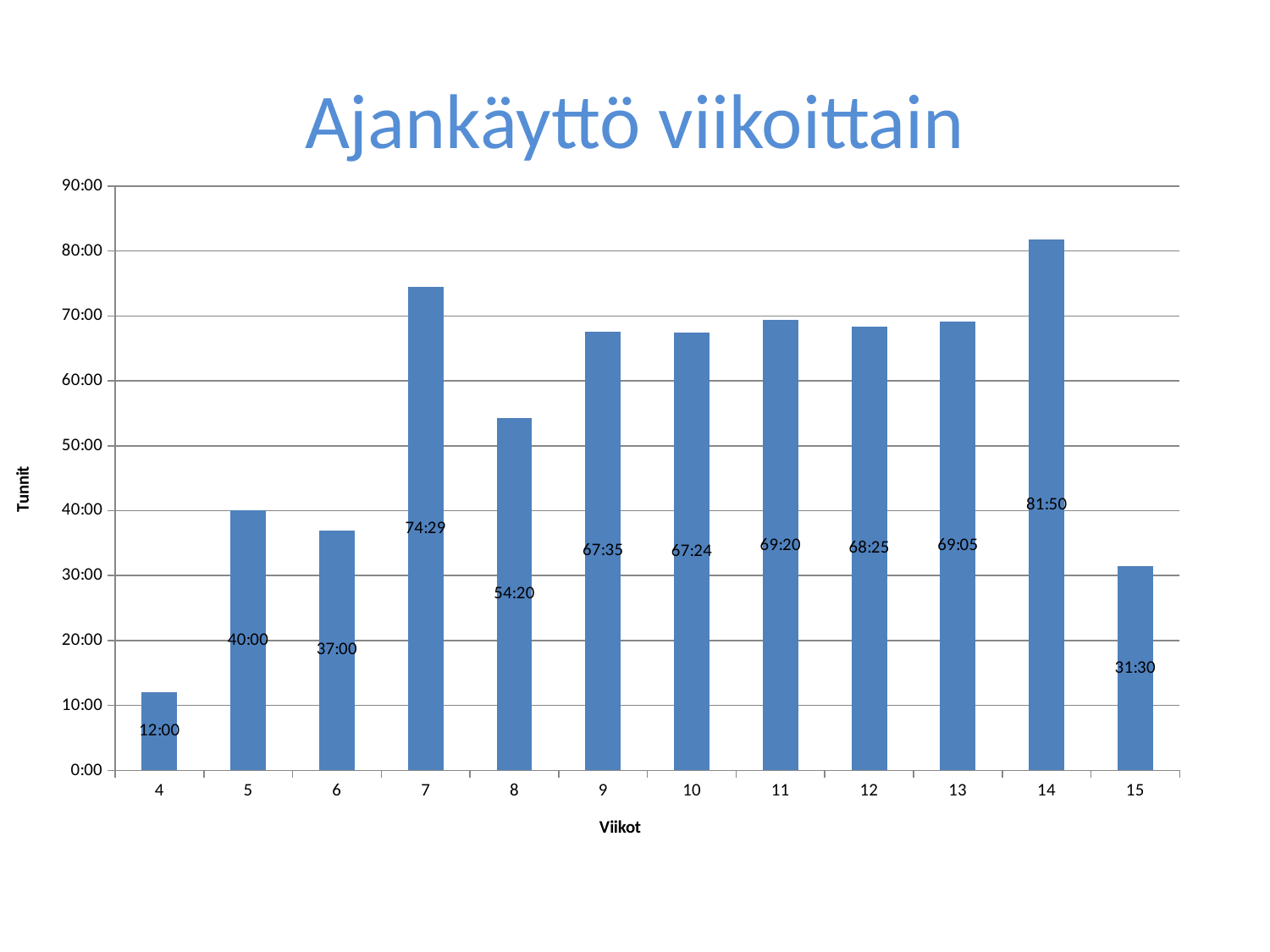
What is the value for week 12? 68:25 Which week has the lowest value? 4 What is the difference between the values for week 14 and week 7? 7:21 Is the value for week 11 greater or less than 60:00? greater What is the value for week 7? 74:29 How many weeks are shown on the x axis? 12 What kind of chart is shown on the slide? bar chart What is the title of the chart? Ajankäyttö viikoittain What is the difference between the values for week 5 and week 6? 3:00 Which is larger, the value for week 8 or the value for week 9? week 9 What is the value for week 15? 31:30 Which week has the highest value? 14